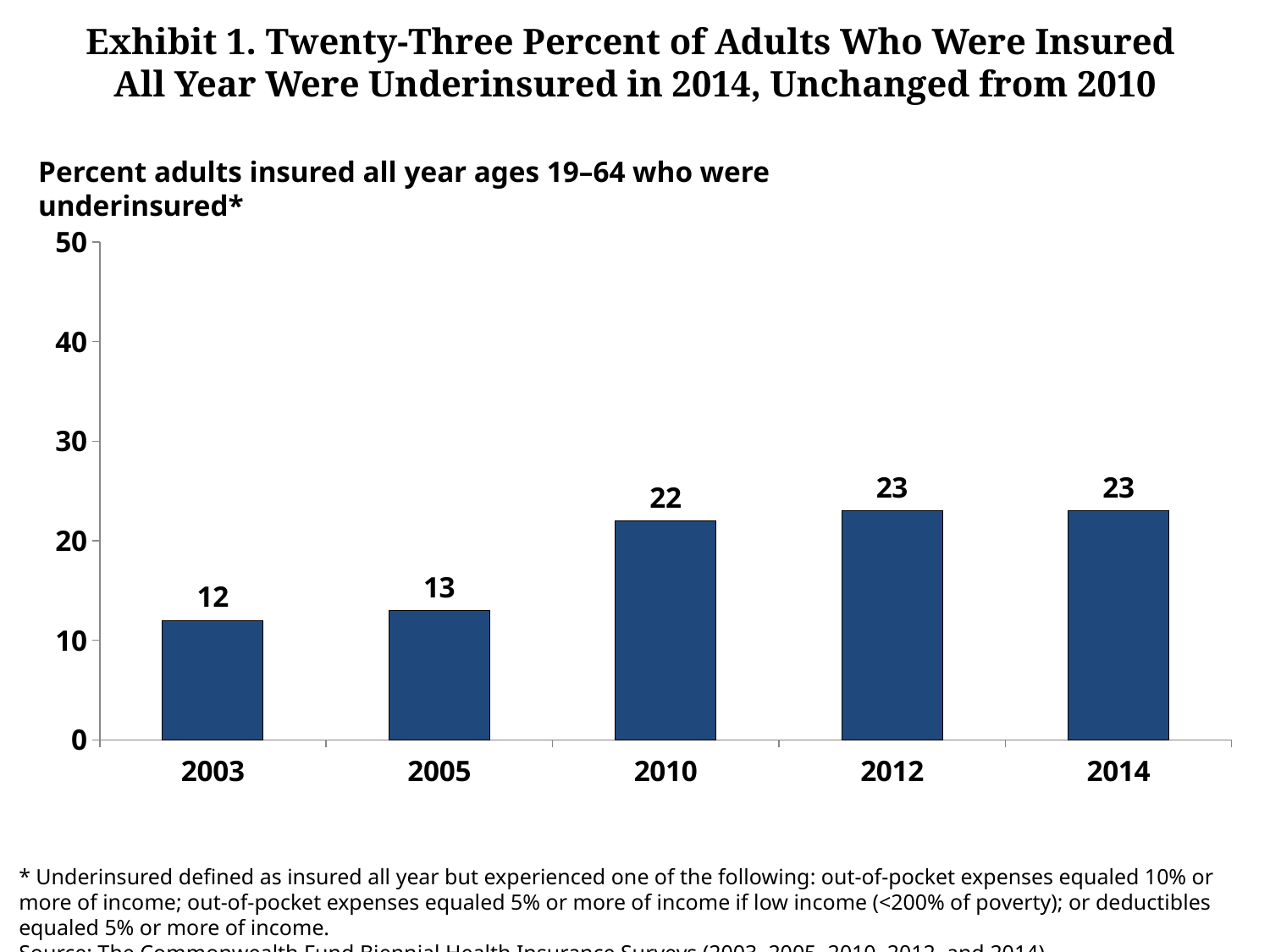
What kind of chart is shown on the slide? bar chart Do the values generally rise or fall from 2003 to 2014? rise What is the value for 2010? 22 What is the highest value shown on the y axis? 50 What is the difference between the values for 2010 and 2005? 9 What is the value for 2014? 23 What is the difference between the values for 2014 and 2003? 11 Which is larger, the value for 2005 or the value for 2010? 2010 Which year has the lowest value? 2003 What is the value for 2003? 12 How many years are shown on the x axis? 5 Is the value for 2012 greater or less than 30? less